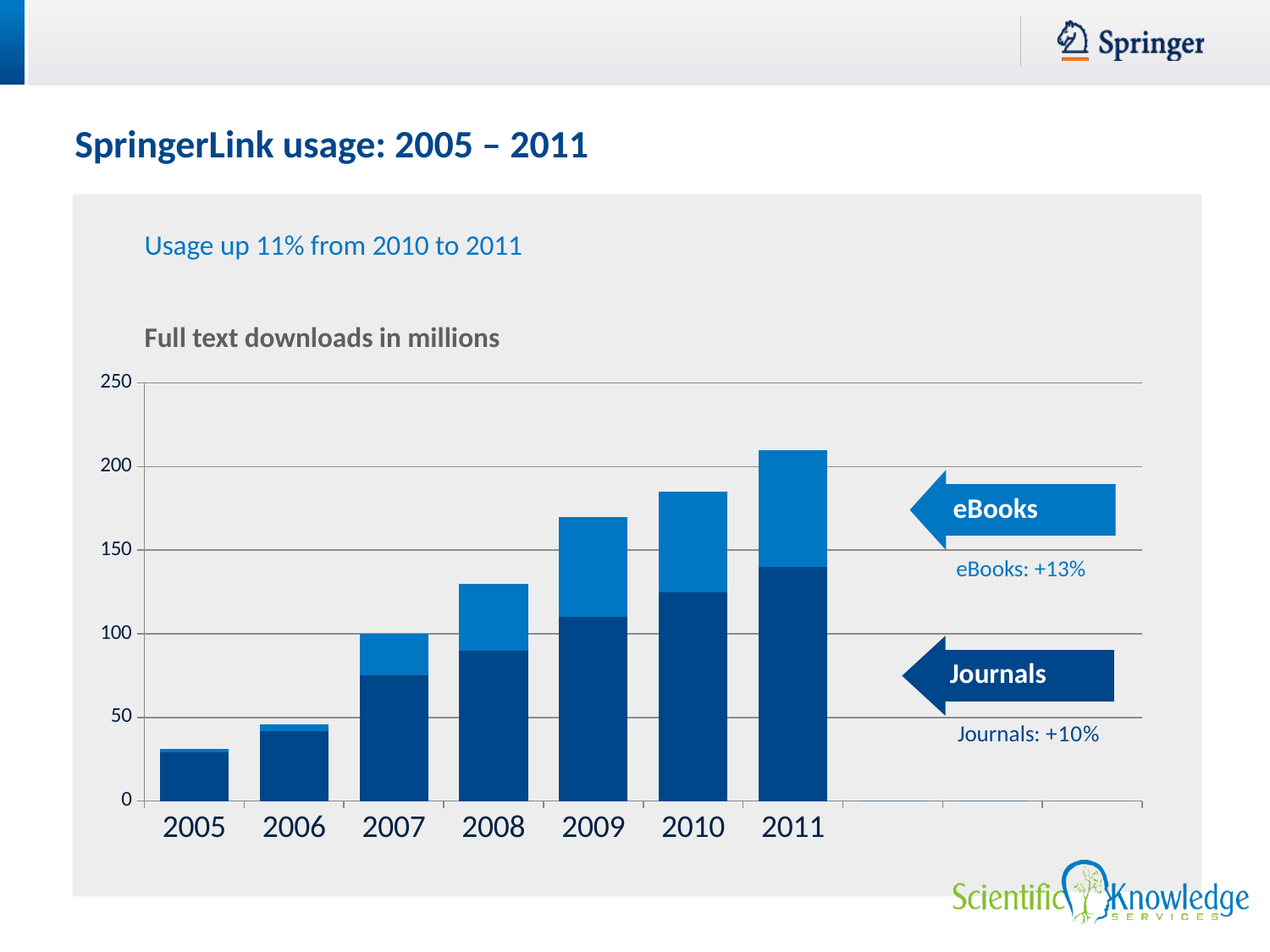
Which year has the lowest total full text downloads? 2005 Which year has the larger total full text downloads, 2008 or 2009? 2009 What are the two series shown in the stacked bars? eBooks and Journals How many years are shown along the x axis of the chart? 7 How many series does the chart show? 2 Is the total value for 2005 greater or less than 50? less What unit does the chart heading say the full text downloads are measured in? millions Is the total value for 2011 greater or less than 200? greater Do total full text downloads rise or fall from 2005 to 2011? rise Which year has the highest total full text downloads? 2011 Is the total value for 2009 greater or less than 150? greater What kind of chart is shown on the slide? bar chart